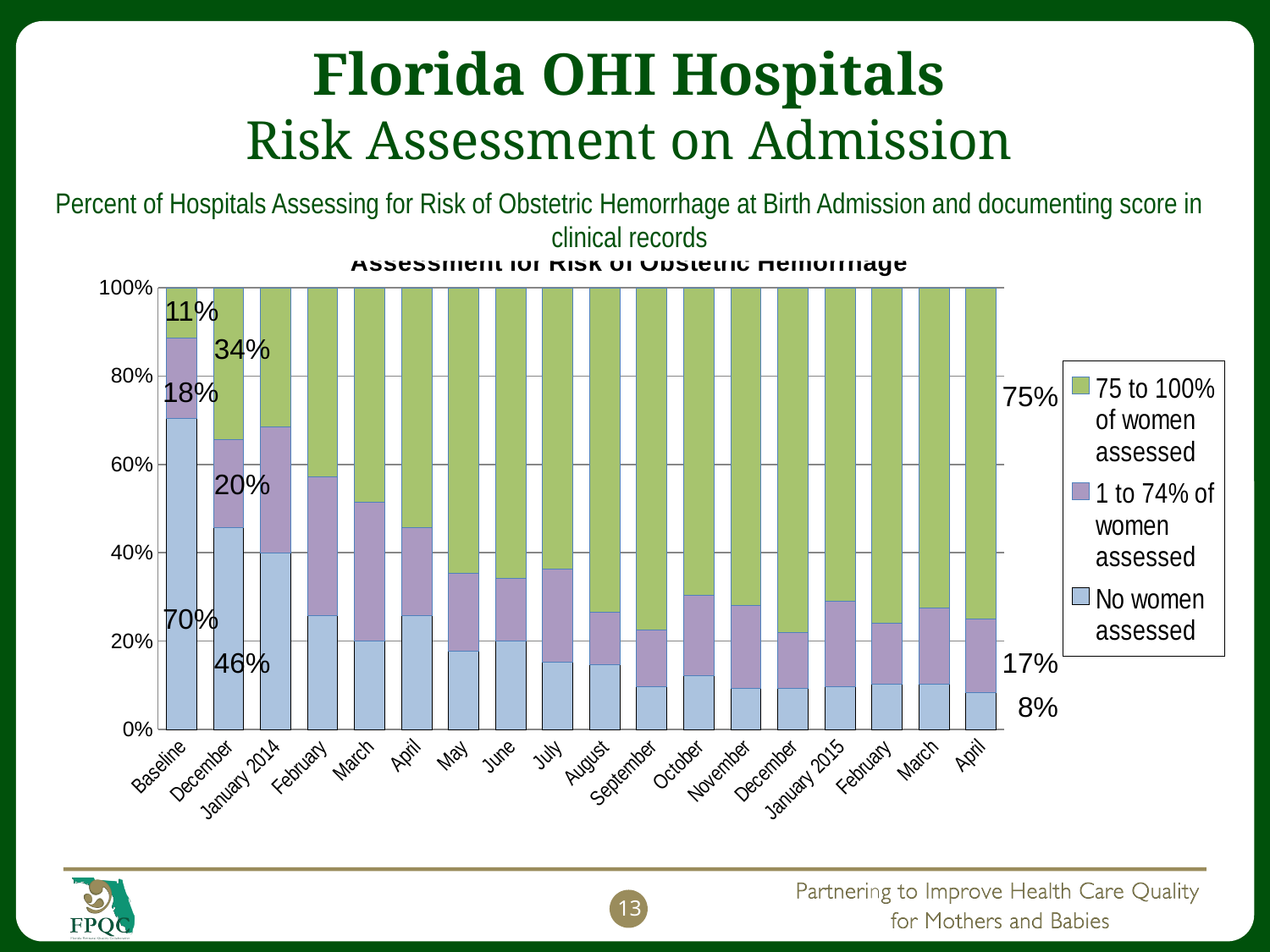
What kind of chart is shown on the slide? Stacked bar chart What percentage of hospitals had no women assessed at Baseline? 70% Which has a larger share of hospitals with no women assessed: Baseline or the final April bar? Baseline Does the share of hospitals with no women assessed rise or fall from Baseline to the final April bar? Fall How many series does the legend list? 3 By how many percentage points did the share of hospitals with 75 to 100% of women assessed increase from Baseline (11%) to the final April bar (75%)? 64 percentage points Is the value for No women assessed in September greater or less than 20%? less What percentage of hospitals had 1 to 74% of women assessed in the first December bar? 20% What percentage of hospitals had no women assessed in the final April bar? 8% What percentage of hospitals had 75 to 100% of women assessed at Baseline? 11% What percentage of hospitals had 75 to 100% of women assessed in the final April bar? 75% How many bars (time periods) are plotted on the x axis? 18